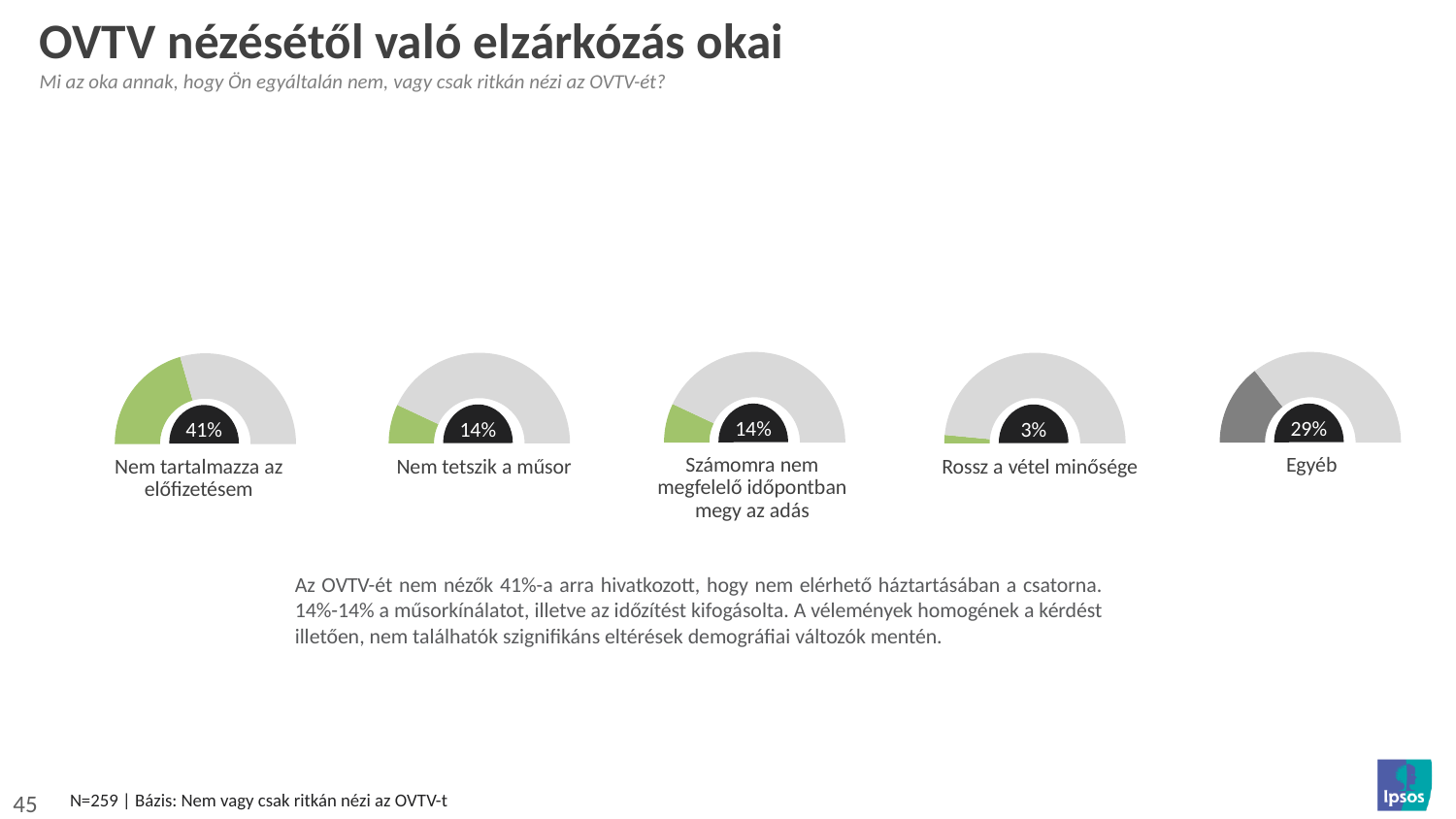
Across the five gauges on the slide, which reason has the highest percentage? Nem tartalmazza az előfizetésem Across the five gauges on the slide, which reason has the lowest percentage? Rossz a vétel minősége Which gauge on the slide uses a dark grey fill instead of green? Egyéb What percentage is shown in the gauge labelled "Egyéb"? 29% What percentage is shown in the gauge labelled "Nem tetszik a műsor"? 14% What is the difference between the percentage for "Nem tartalmazza az előfizetésem" and the percentage for "Egyéb"? 12% What percentage is shown in the gauge labelled "Nem tartalmazza az előfizetésem"? 41% How many gauge charts are shown on the slide? 5 What kind of chart is used to display each reason on the slide? doughnut chart What percentage is shown in the gauge labelled "Számomra nem megfelelő időpontban megy az adás"? 14% Which is larger: the percentage for "Egyéb" or the percentage for "Nem tetszik a műsor"? Egyéb What percentage is shown in the gauge labelled "Rossz a vétel minősége"? 3%